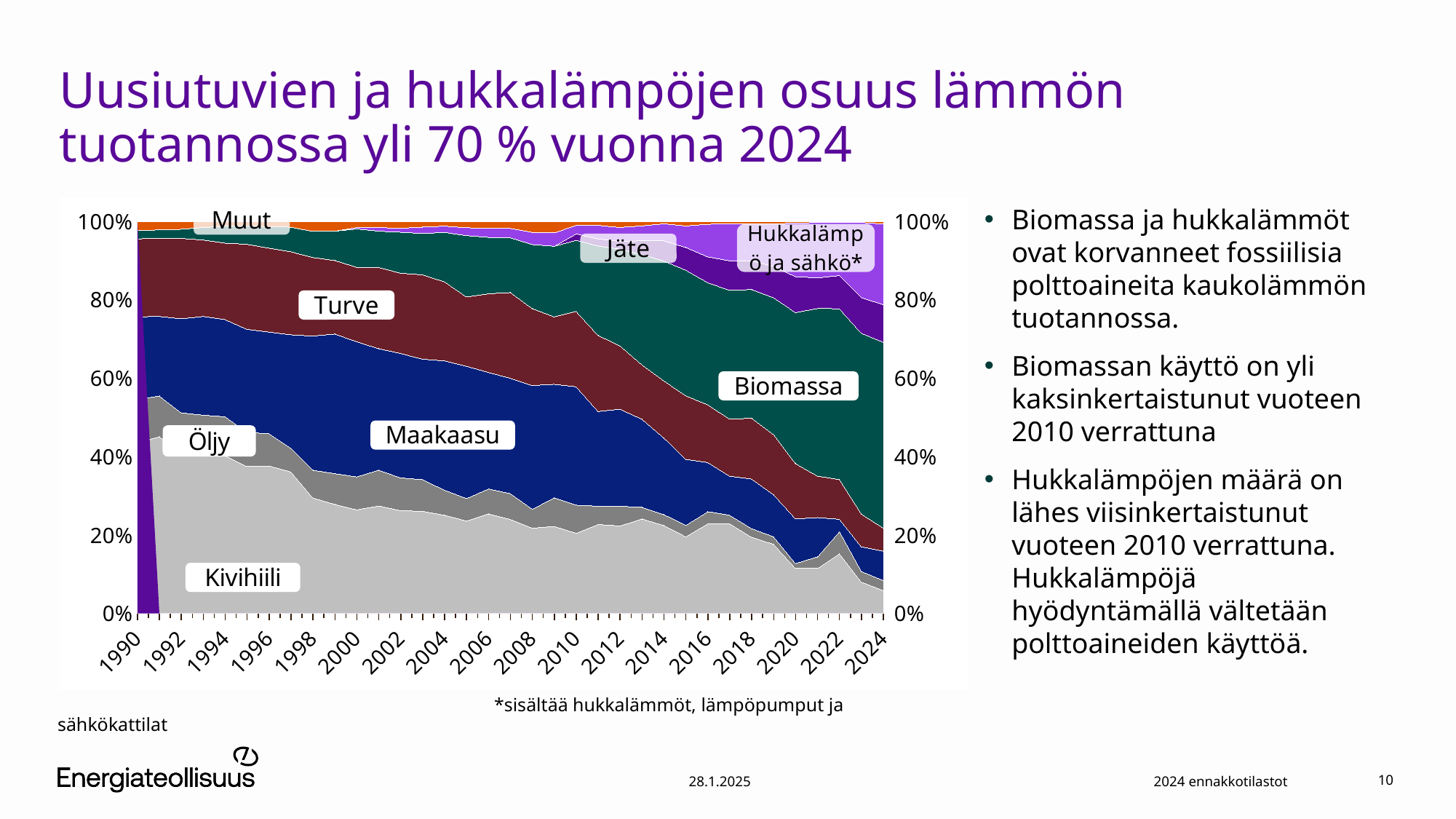
Does the share of Kivihiili rise or fall from 1992 to 2024? Fall Which series forms the top layer of the stacked area chart? Muut How many fuel/energy source series are labelled in the chart? 8 In 2024, which has the larger share, Biomassa or Kivihiili? Biomassa What kind of chart is shown on the slide? Stacked area chart Does the share of Maakaasu rise or fall from 2000 to 2024? Fall How many year labels are shown on the x axis of the chart? 18 Which series forms the bottom layer of the stacked area chart? Kivihiili Does the share of Biomassa rise or fall from 1992 to 2024? Rise Is the share of Kivihiili in 2024 greater or less than 20%? less